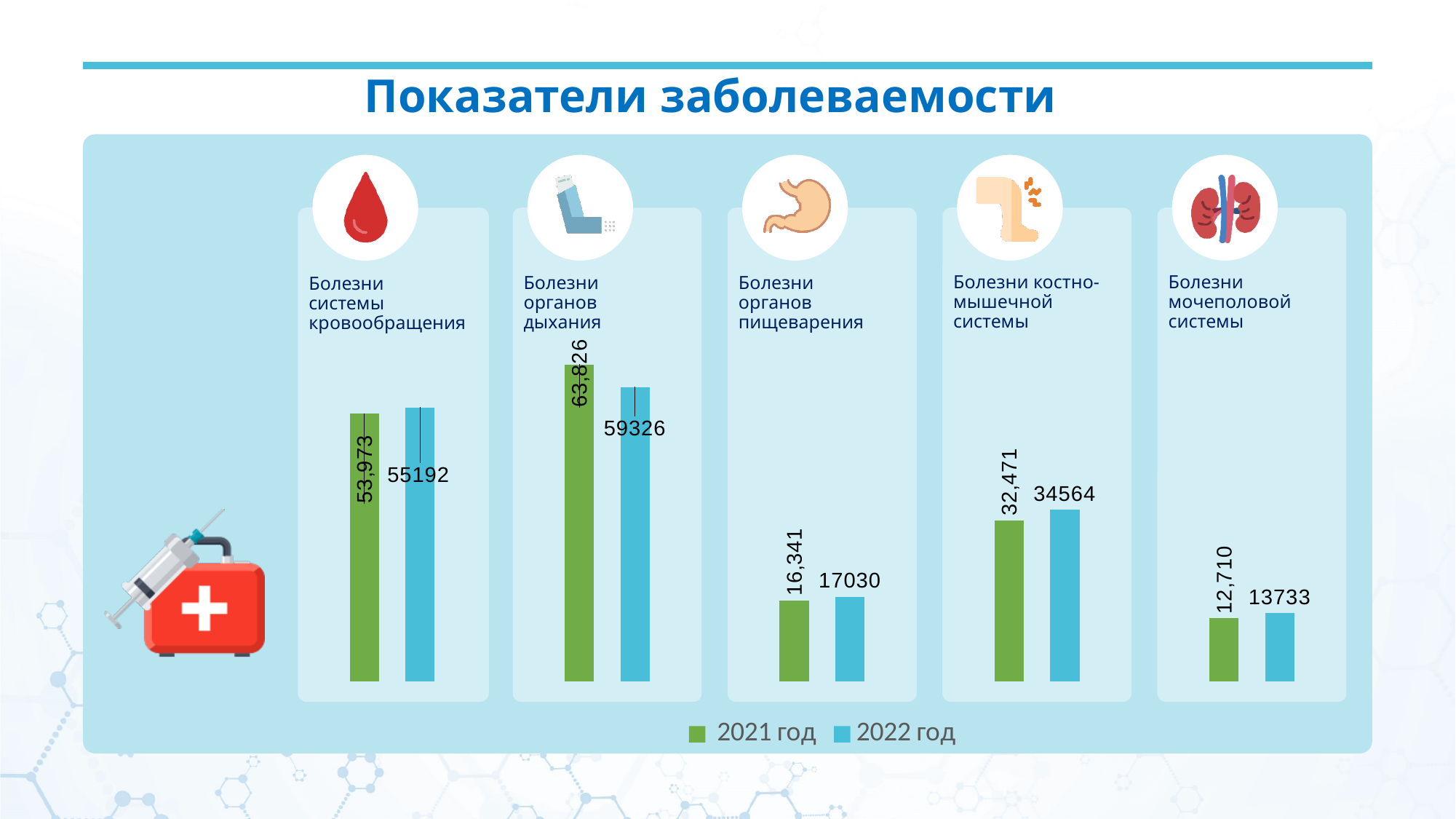
What type of chart is shown on the slide? Bar chart How many disease categories are shown in the chart? 5 What is the 2022 value for Болезни системы кровообращения? 55192 What is the difference between the 2022 and 2021 values for Болезни органов пищеварения? 689 How many series does the legend list? 2 What is the 2022 value for Болезни костно-мышечной системы? 34564 What is the 2021 value for Болезни мочеполовой системы? 12,710 What is the difference between the 2021 and 2022 values for Болезни органов дыхания? 4500 Which category has the highest 2022 value? Болезни органов дыхания Which category has the lowest 2021 value? Болезни мочеполовой системы Which is larger for Болезни костно-мышечной системы: the 2021 value or the 2022 value? 2022 What is the 2021 value for Болезни органов дыхания? 63,826